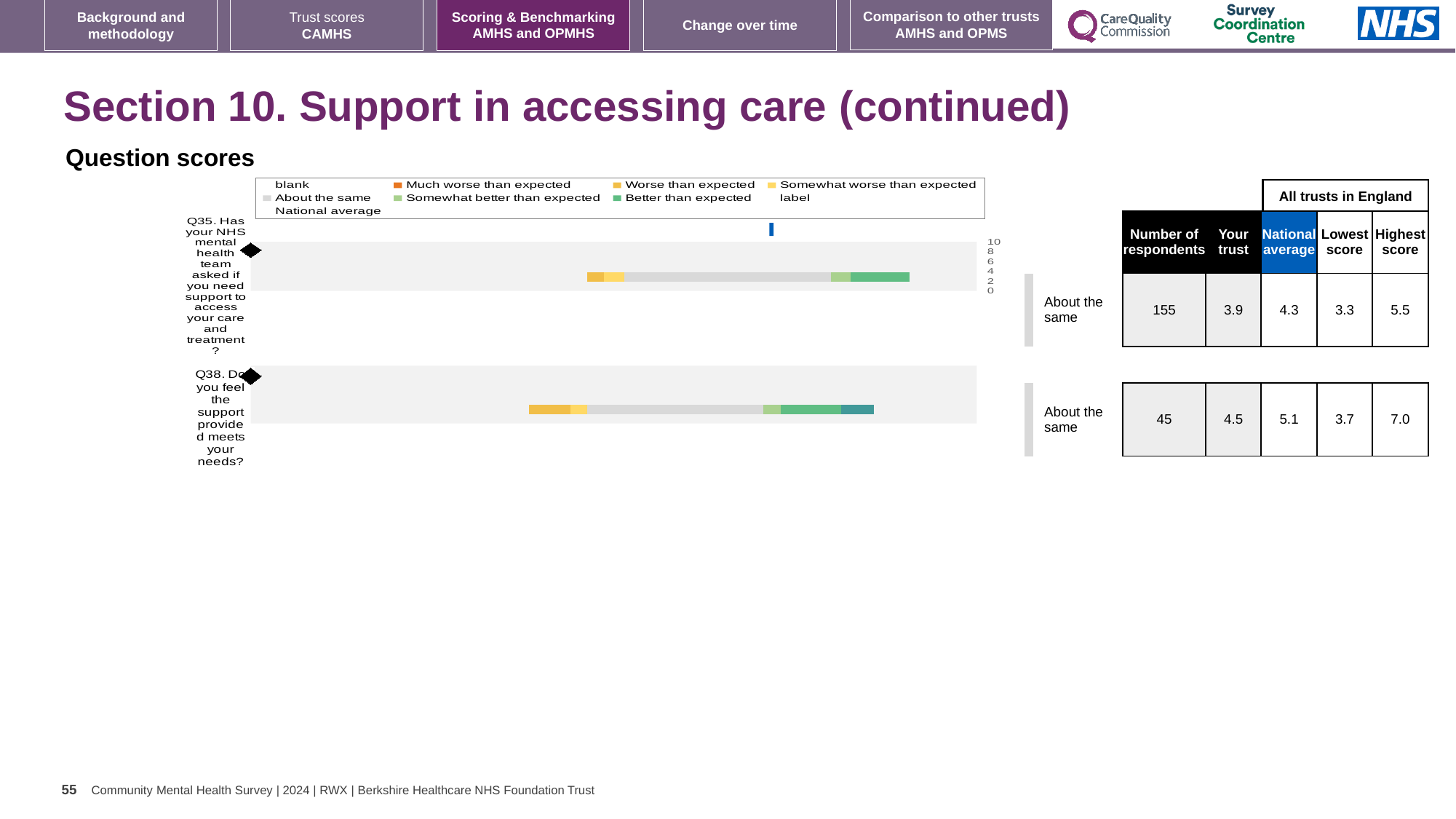
How many questions (bars) are plotted in the chart? 2 For Q38, which is larger: the "Your trust" score or the national average? national average In the chart legend, what colour represents "Much worse than expected"? orange What is the difference between the highest score and the lowest score for Q35? 2.2 In the table beside the chart, what is the "Your trust" score for Q38? 4.5 In the table beside the chart, what is the national average for Q35? 4.3 In the table beside the chart, what is the highest score for Q38? 7.0 In the chart legend, what colour represents "About the same"? grey In the table beside the chart, what is the lowest score for Q35? 3.3 In the table beside the chart, how many respondents are listed for Q35? 155 Which question has more respondents, Q35 or Q38? Q35 What kind of chart is shown under the heading "Question scores"? bar chart